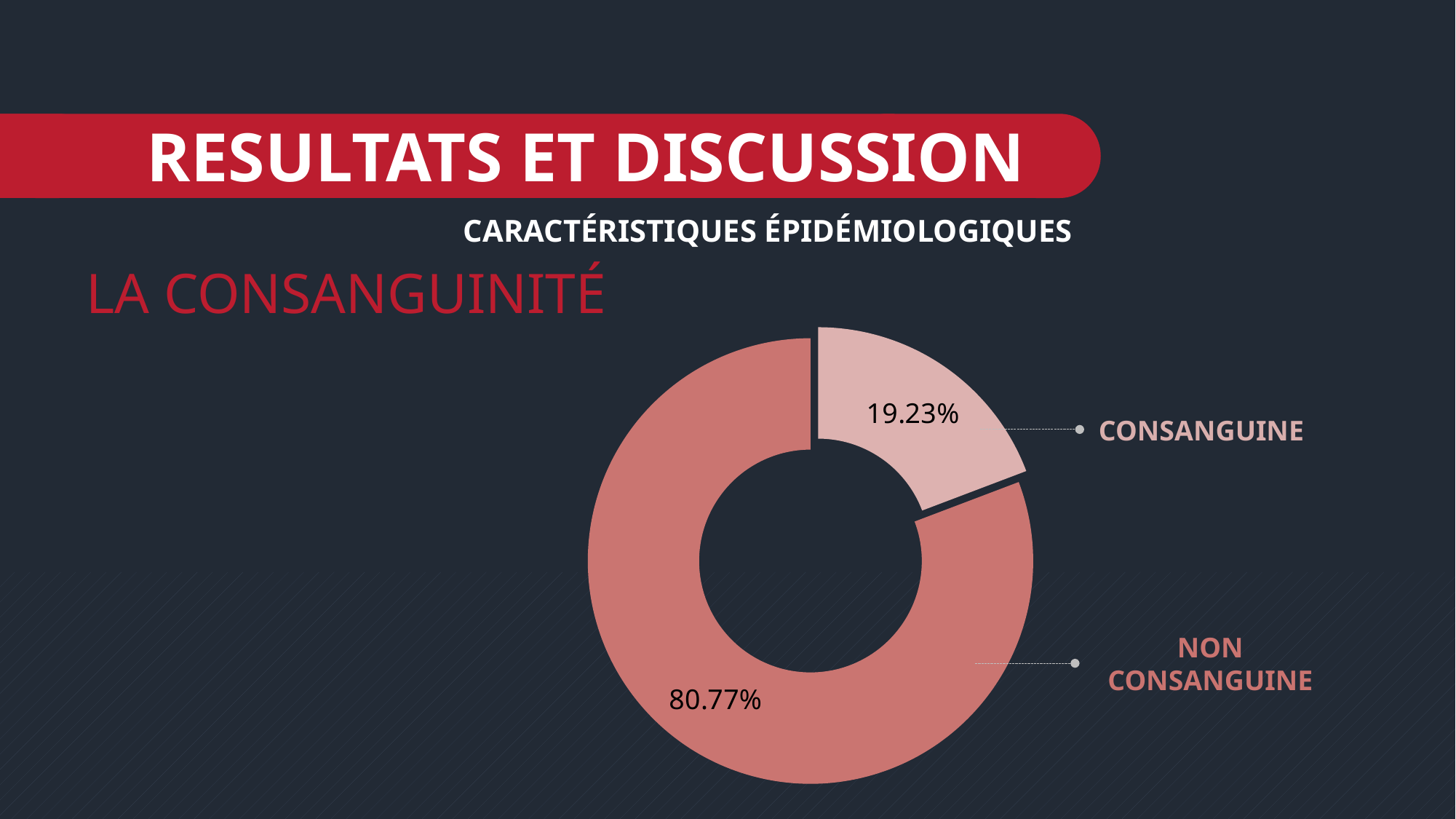
What is the total of the two percentages shown on the chart? 100% What is the difference in percentage points between the NON CONSANGUINE and CONSANGUINE shares? 61.54% Which category has the largest share of the chart? NON CONSANGUINE Which category has the smallest share of the chart? CONSANGUINE What percentage of the chart is labelled CONSANGUINE? 19.23% Which slice is drawn in the lighter pink colour? CONSANGUINE What is the share of the chart taken by the CONSANGUINE slice? 19.23% What is the red subtitle above the chart? LA CONSANGUINITÉ Which is larger, the CONSANGUINE share or the NON CONSANGUINE share? NON CONSANGUINE What kind of chart is shown on the slide? Pie chart (doughnut) How many categories does the chart show? 2 What percentage of the chart is labelled NON CONSANGUINE? 80.77%